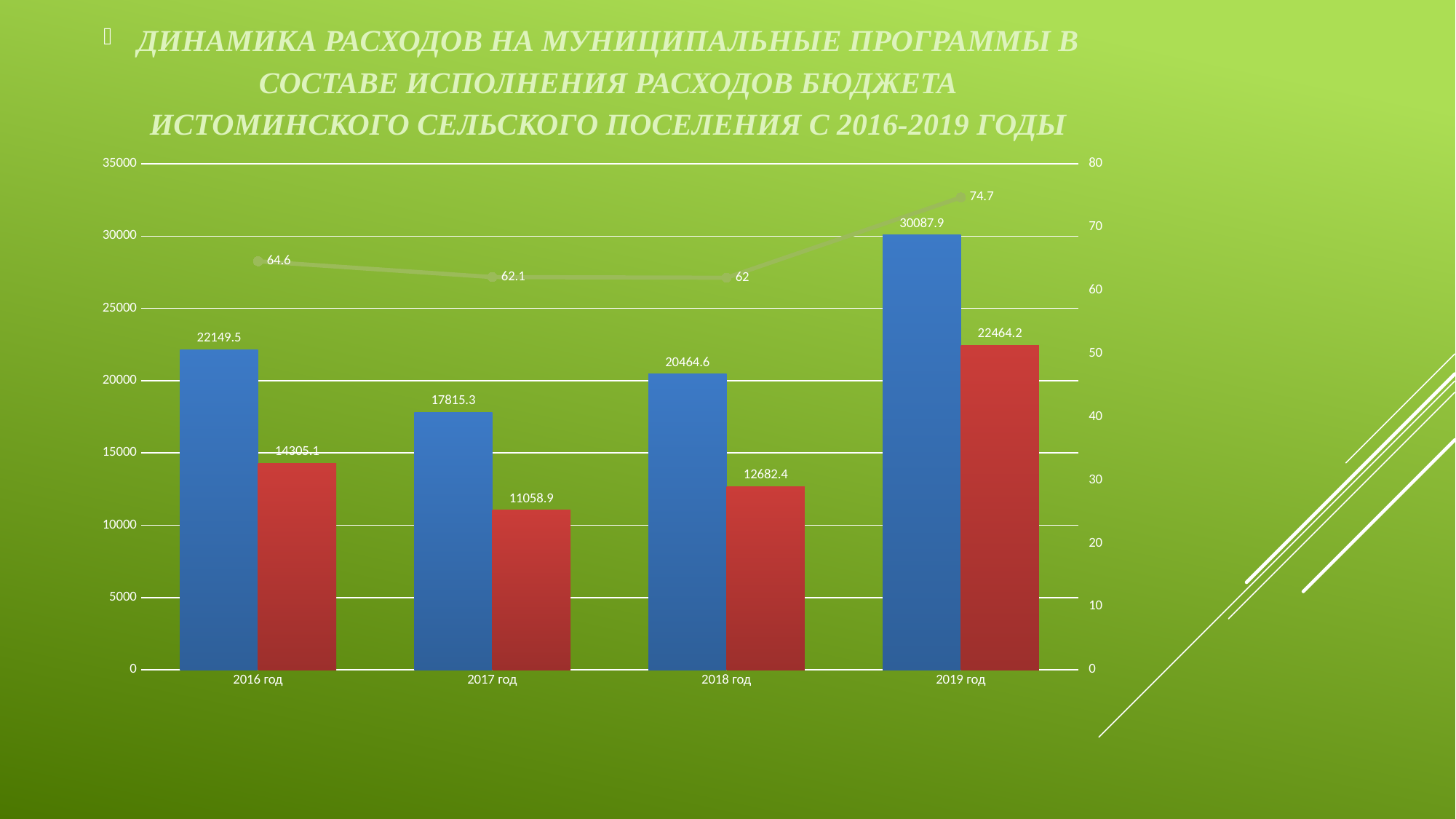
Does the line series rise or fall from 2018 год to 2019 год? Rise What is the difference between the blue bar and the red bar for 2018 год? 7782.2 What kind of chart is this? Combined bar and line chart What is the maximum value shown on the right-hand axis? 80 In which year is the blue bar the highest? 2019 год What value does the line series show for 2016 год? 64.6 What is the value of the blue bar for 2019 год? 30087.9 In which year is the red bar the lowest? 2017 год How many years are shown on the x axis? 4 Which is larger: the blue bar for 2016 год or the blue bar for 2018 год? 2016 год Is the value of the red bar for 2019 год greater or less than 20000? greater What is the value of the red bar for 2017 год? 11058.9